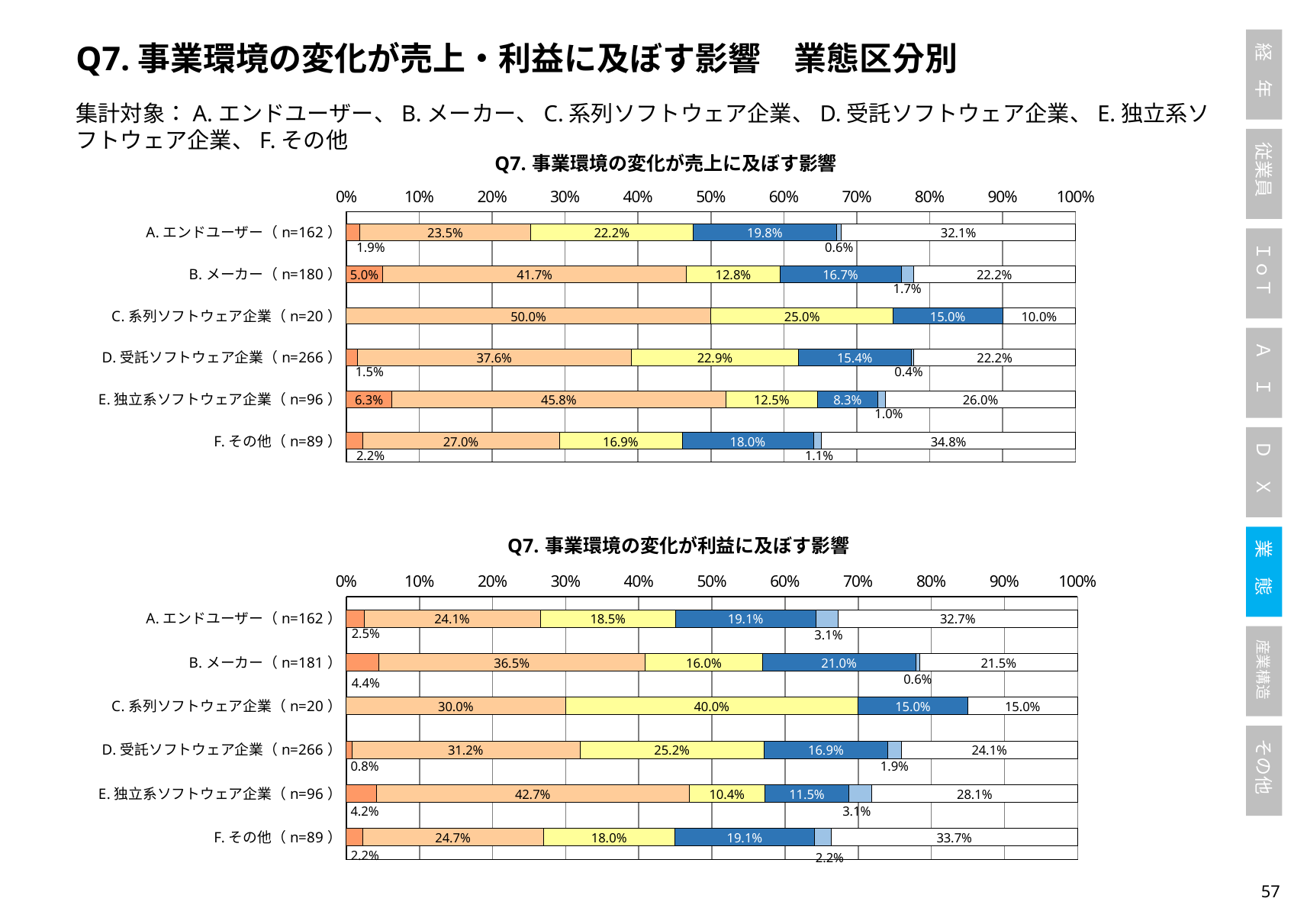
How many categories (bars) are shown in the bottom chart (利益に及ぼす影響)? 6 In the bottom chart (利益に及ぼす影響), what is the value of the yellow segment for C. 系列ソフトウェア企業? 40.0% What is the title of the top chart on the slide? Q7. 事業環境の変化が売上に及ぼす影響 In the bottom chart (利益に及ぼす影響), what is the value of the light orange segment for E. 独立系ソフトウェア企業? 42.7% In the top chart (売上に及ぼす影響), which category has the largest white (rightmost) segment? F. その他 In the top chart (売上に及ぼす影響), what is the value of the light orange segment for C. 系列ソフトウェア企業? 50.0% In the top chart (売上に及ぼす影響), what is the value of the white (rightmost) segment for F. その他? 34.8% In the top chart (売上に及ぼす影響), what is the difference between the light orange segments of B. メーカー and A. エンドユーザー? 18.2% In the top chart (売上に及ぼす影響), which has the larger dark blue segment, A. エンドユーザー or B. メーカー? A. エンドユーザー In the bottom chart (利益に及ぼす影響), what is the difference between the white segments of A. エンドユーザー and D. 受託ソフトウェア企業? 8.6% What kind of chart is the top chart titled 'Q7. 事業環境の変化が売上に及ぼす影響'? Stacked bar chart In the top chart (売上に及ぼす影響), which category has the smallest white (rightmost) segment? C. 系列ソフトウェア企業